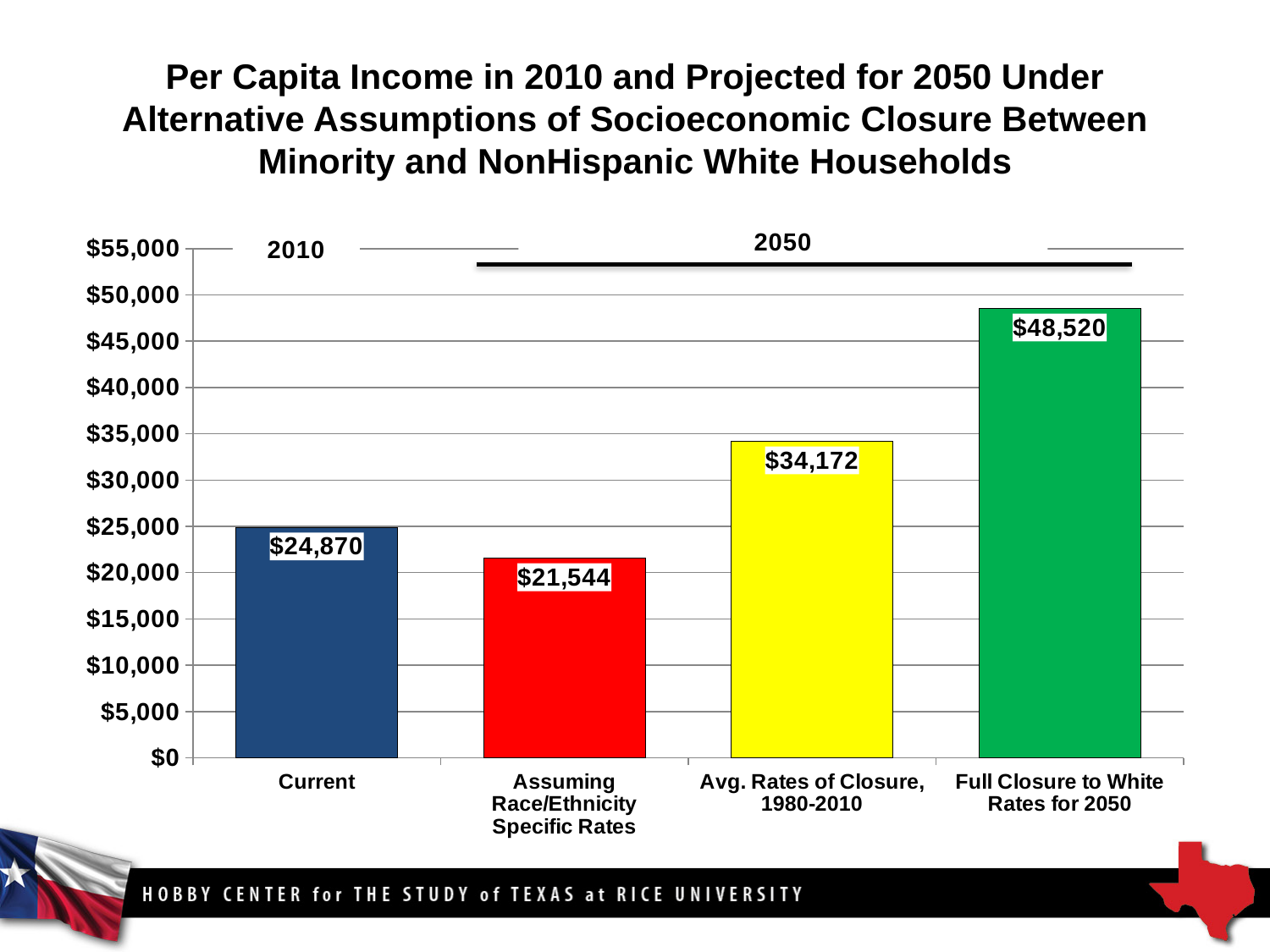
What kind of chart is shown on the slide? Bar chart What is the value shown for Full Closure to White Rates for 2050? $48,520 What colour is the bar for Avg. Rates of Closure, 1980-2010? Yellow How many categories are shown on the x axis? 4 Which is larger, the value for Current or the value for Avg. Rates of Closure, 1980-2010? Avg. Rates of Closure, 1980-2010 Which category has the lowest per capita income? Assuming Race/Ethnicity Specific Rates What is the difference between the Current value and the Assuming Race/Ethnicity Specific Rates value? $3,326 What is the per capita income value shown for the Current category? $24,870 Which category has the highest per capita income? Full Closure to White Rates for 2050 What is the value shown for Assuming Race/Ethnicity Specific Rates? $21,544 What is the value shown for Avg. Rates of Closure, 1980-2010? $34,172 What is the difference between the Full Closure to White Rates for 2050 value and the Current value? $23,650